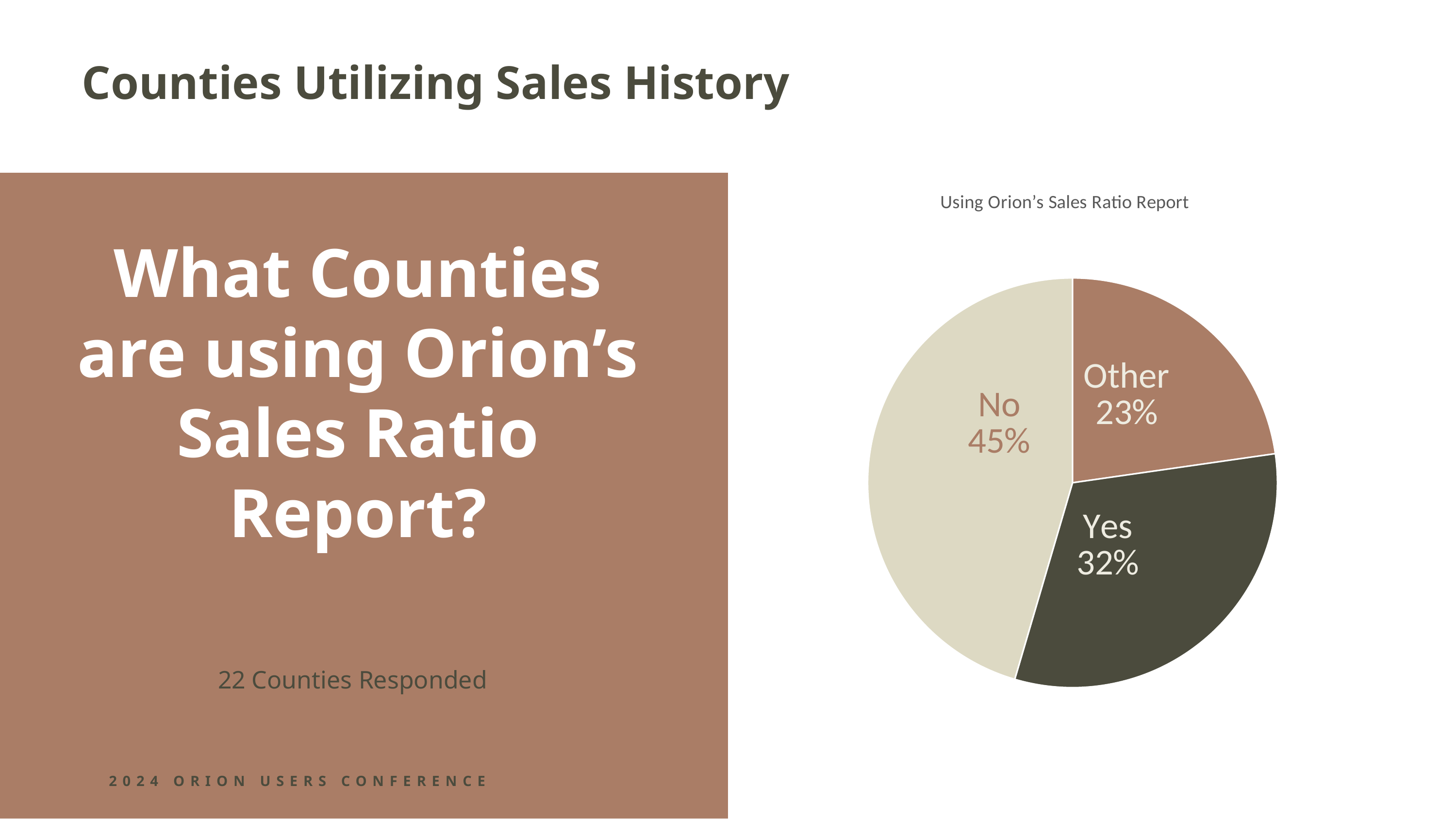
What share of the pie does the "Yes" slice represent? 32% How many counties responded to the survey shown on the slide? 22 Which slice is larger, "Yes" or "Other"? Yes What is the difference in percentage points between the "Yes" and "Other" slices? 9 What share of the pie does the "Other" slice represent? 23% What is the title of the pie chart? Using Orion's Sales Ratio Report What share of the pie does the "No" slice represent? 45% How many slices does the pie chart have? 3 Which slice of the pie is the largest? No Which slice of the pie is the smallest? Other What is the difference in percentage points between the "No" and "Yes" slices? 13 What kind of chart is shown on the slide? Pie chart